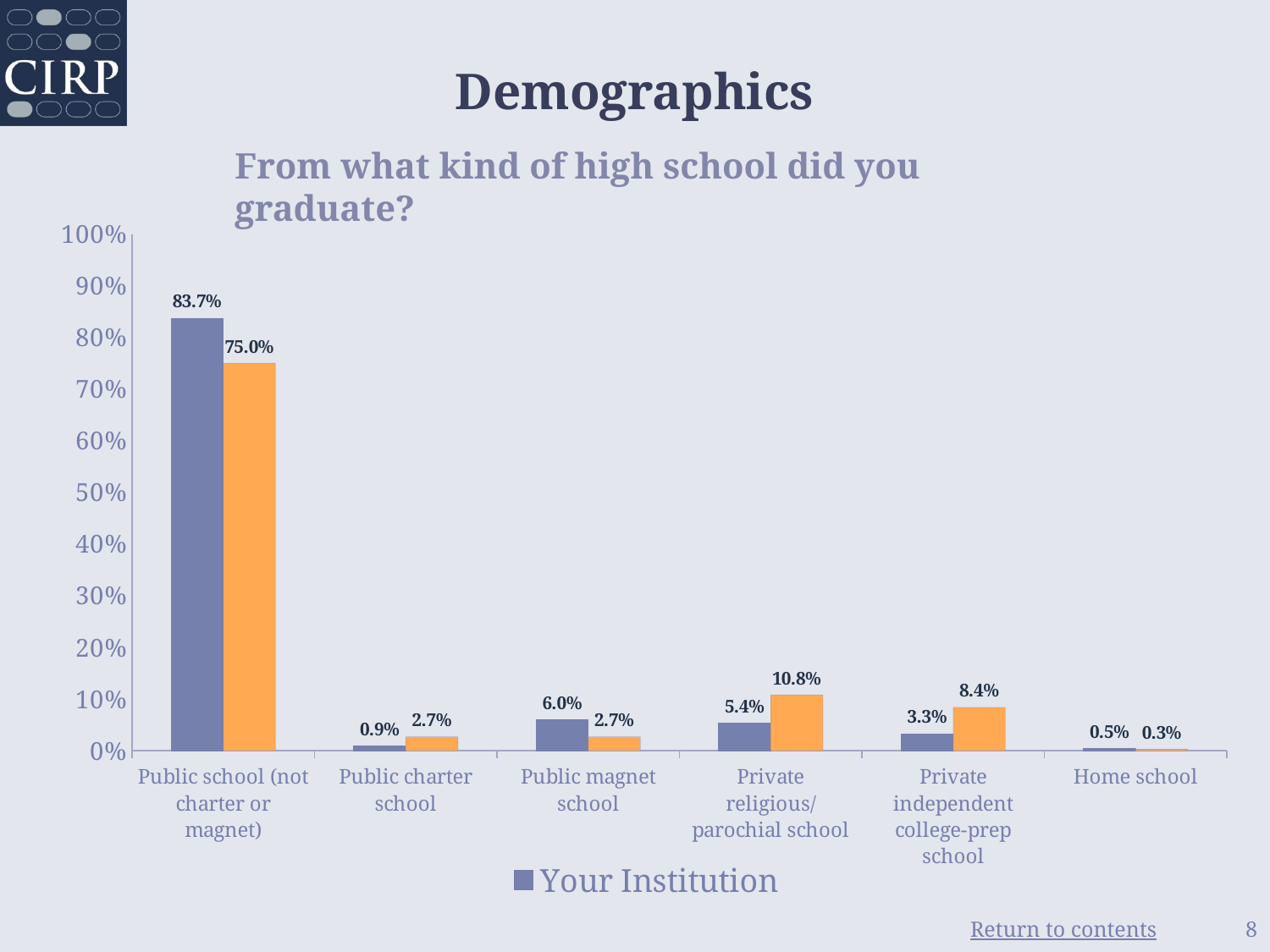
How many categories are shown on the x axis? 6 What kind of chart is shown on the slide? bar chart What is the value for Your Institution for Public school (not charter or magnet)? 83.7% What is the value for Your Institution for Private independent college-prep school? 3.3% How many series does the legend list? 1 Which category has the highest value for Your Institution? Public school (not charter or magnet) What is the difference between the Your Institution values for Public magnet school and Public charter school? 5.1% For Your Institution, which is larger: Private religious/parochial school or Private independent college-prep school? Private religious/parochial school Which category has the lowest value for Your Institution? Home school Is the value for Your Institution for Public school (not charter or magnet) greater or less than 80%? greater What is the question shown as the chart's title? From what kind of high school did you graduate? What is the value for Your Institution for Public magnet school? 6.0%